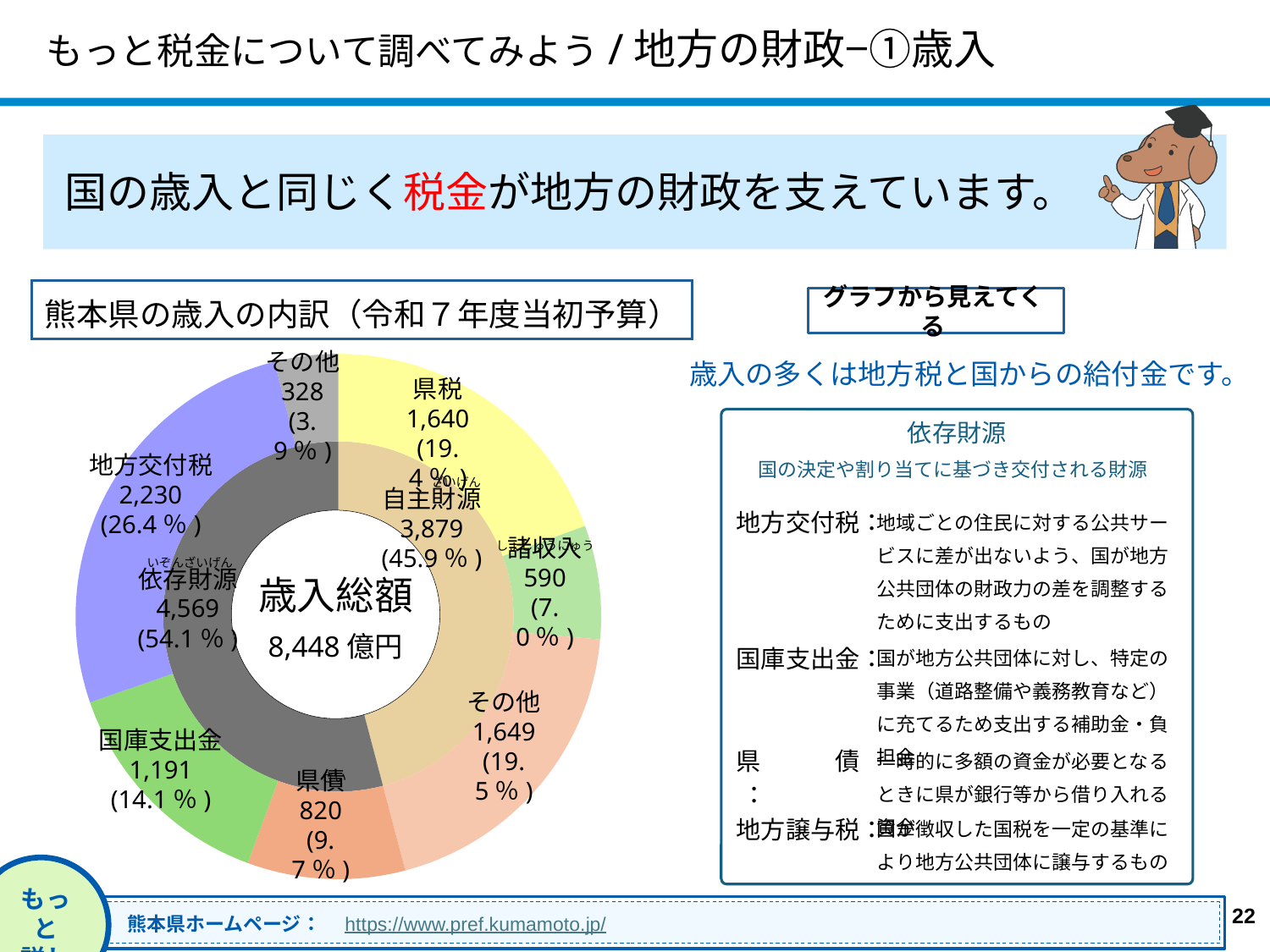
What type of chart is shown on the slide? Doughnut chart Which outer-ring category has the smallest value in the chart? その他 (328) What is the difference between the values for 地方交付税 and 国庫支出金? 1,039 What percentage share does 県税 have in the chart? 19.4% What is the title of the chart? 熊本県の歳入の内訳（令和７年度当初予算） What is the total revenue (歳入総額) shown in the centre of the chart? 8,448 億円 What is the value shown for 自主財源 in the inner ring? 3,879 Which is larger, the value for 県債 or the value for 諸収入? 県債 What is the value shown for 国庫支出金? 1,191 What percentage share does 依存財源 have in the inner ring of the chart? 54.1% What is the value shown for 地方交付税 in the chart? 2,230 Which outer-ring category has the largest value in the chart? 地方交付税